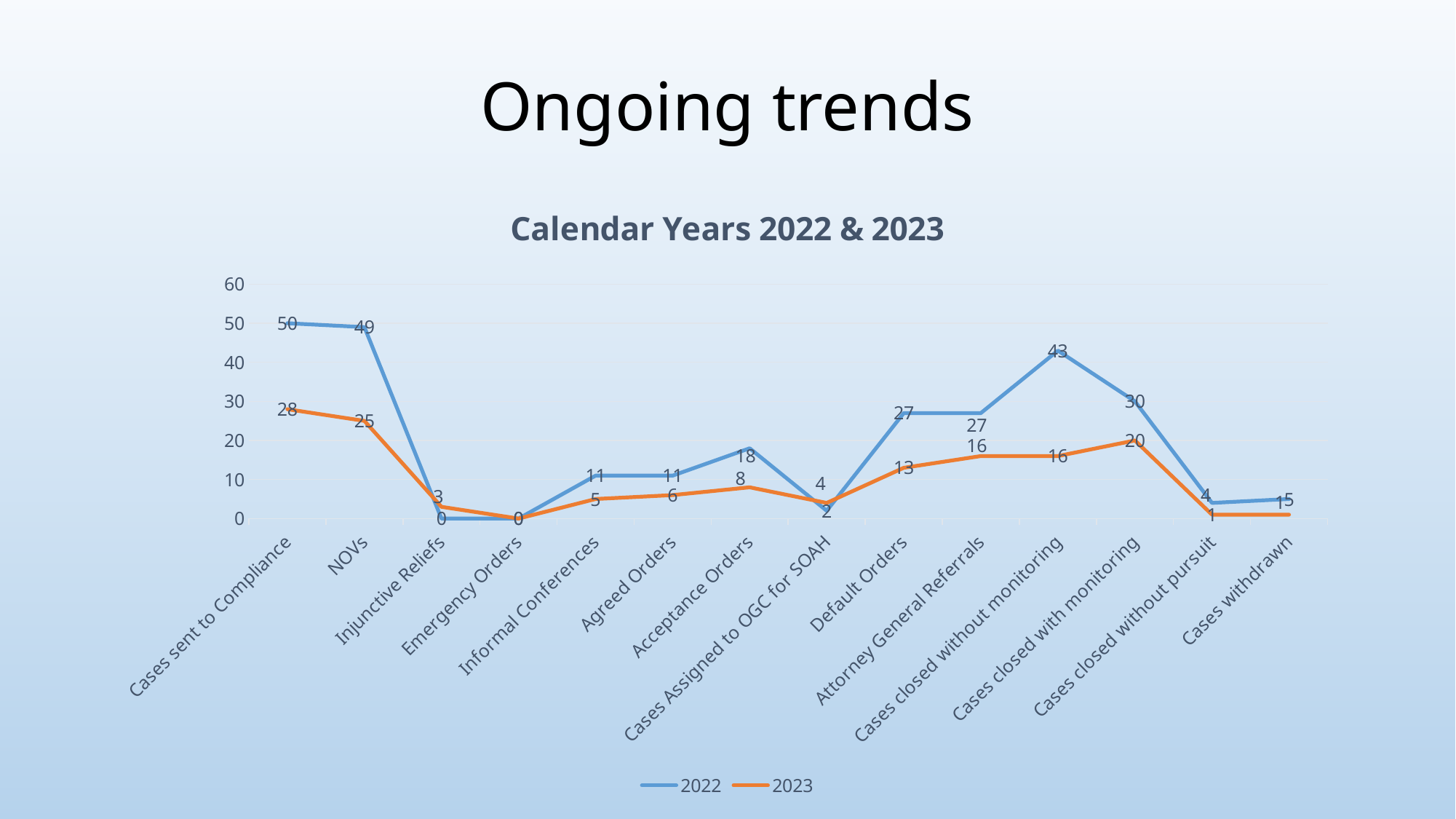
What type of chart is shown on the slide? line chart Which category has the highest 2022 value? Cases sent to Compliance How many series does the legend list? 2 What is the 2023 value for Attorney General Referrals? 16 What is the difference between the 2022 and 2023 values for NOVs? 24 How many categories are shown on the x axis? 14 What is the title of the chart? Calendar Years 2022 & 2023 Which category has the highest 2023 value? Cases sent to Compliance What is the difference between the 2022 and 2023 values for Cases closed with monitoring? 10 Which is larger for Default Orders, the 2022 value or the 2023 value? 2022 What is the 2022 value for Cases closed without monitoring? 43 What is the 2023 value for Cases sent to Compliance? 28